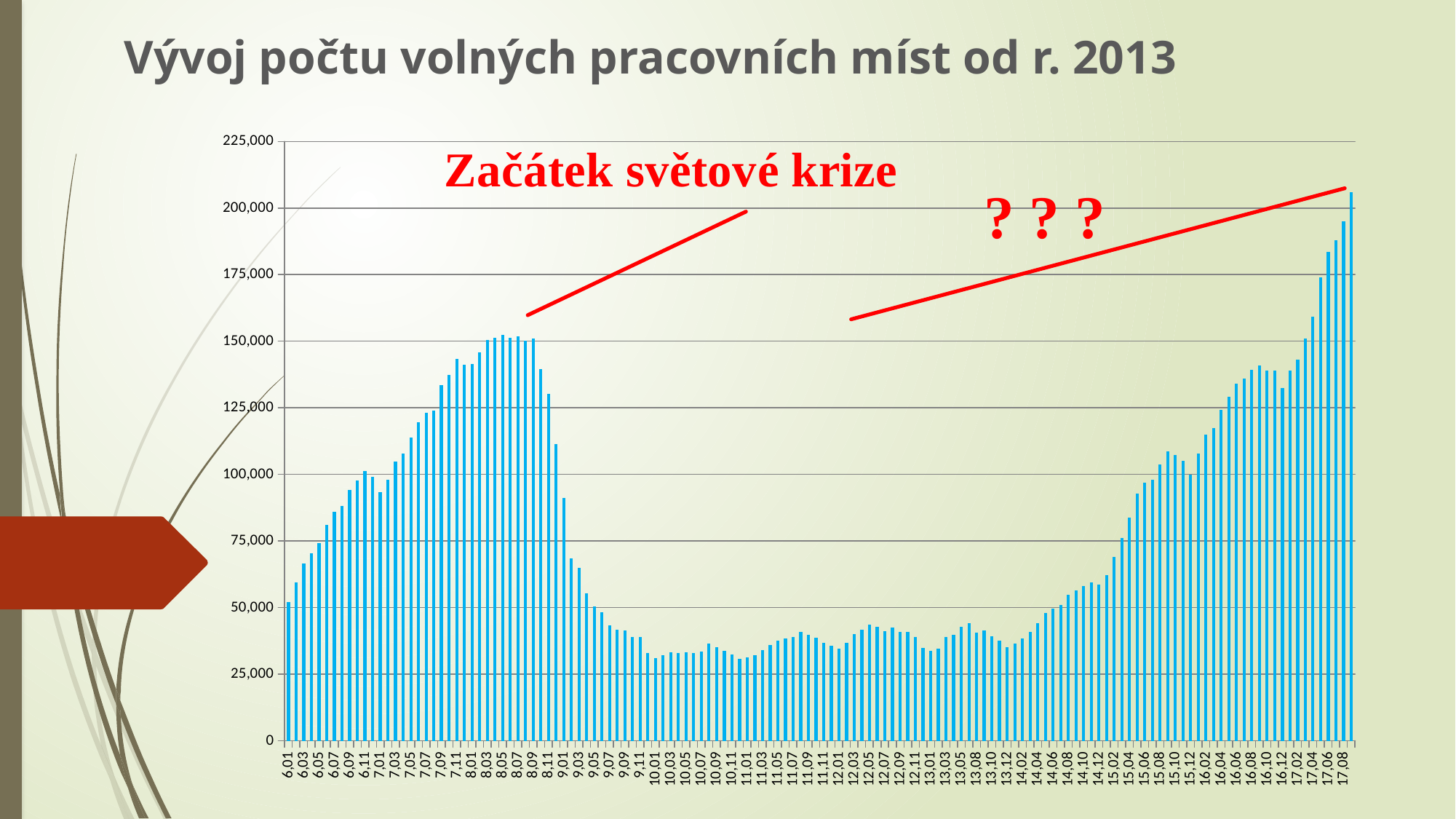
Which is larger, the value for 8.05 or the value for 11.01? 8.05 Is the value for 16.06 greater or less than 100,000? greater Which is larger, the value for 17.08 or the value for 8.05? 17.08 What red annotation text is placed above the peak of the bars around 2008? Začátek světové krize What kind of chart is shown on the slide? bar chart Do the values rise or fall along the x axis between 14.02 and 17.08? rise Do the values rise or fall along the x axis between 8.09 and 9.09? fall Is the value for 8.07 greater or less than 125,000? greater Is the value for 10.01 greater or less than 75,000? less What is the title of the chart on the slide? Vývoj počtu volných pracovních míst od r. 2013